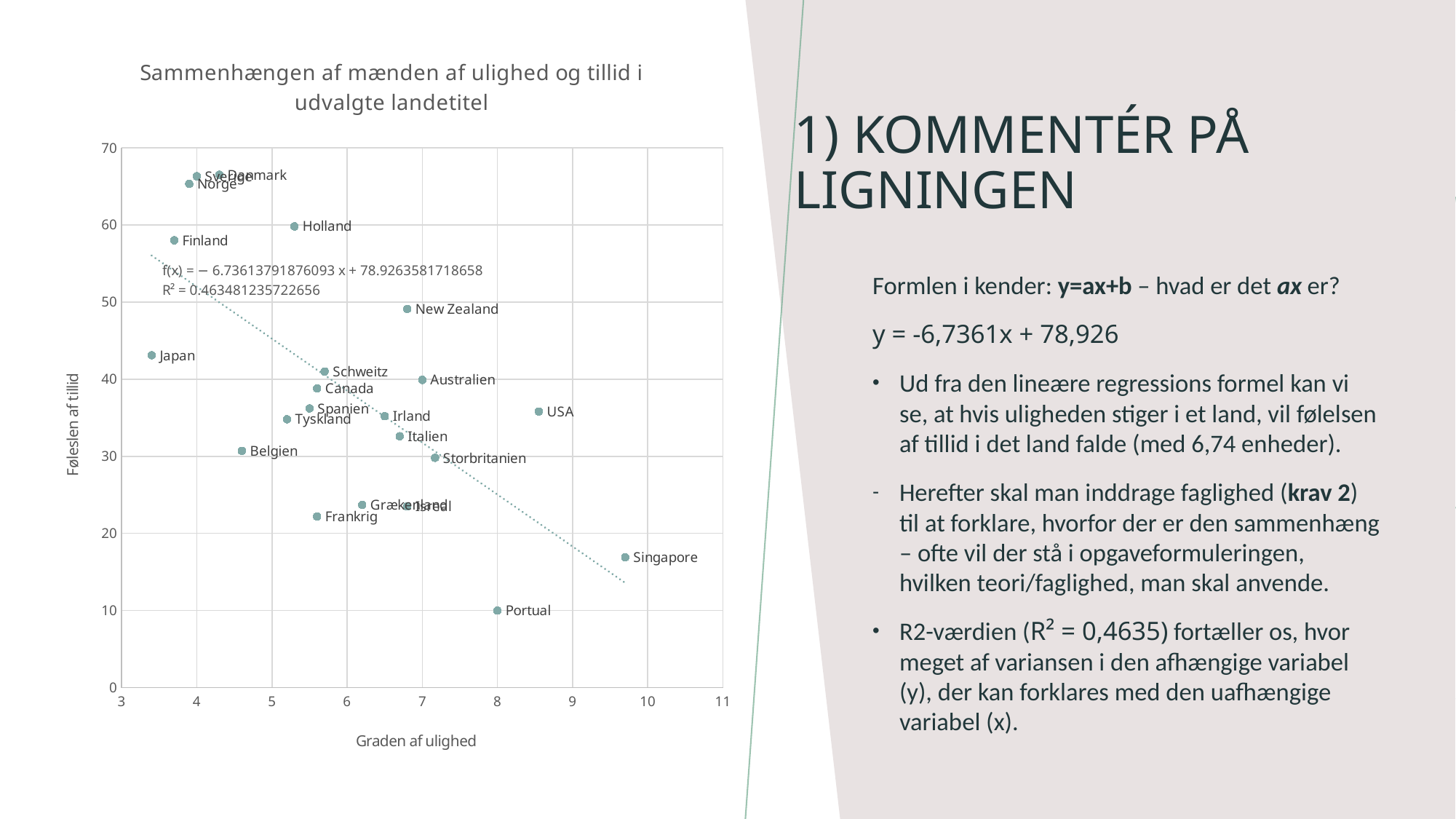
Which has the higher vertical-axis value, Portual or Singapore? Singapore What is the title of the chart? Sammenhængen af mænden af ulighed og tillid i udvalgte landetitel Does the trend line show trust rising or falling as inequality increases along the x axis? falling What R² value is printed on the chart? 0.463481235722656 Is the vertical-axis value for Singapore greater or less than 20? less Which country has the highest value on the horizontal axis (Graden af ulighed)? Singapore What kind of chart is shown on the slide? scatter chart Which country has the lowest value on the vertical axis (Føleslen af tillid)? Portual Which has the higher vertical-axis value, Japan or Belgien? Japan Is the vertical-axis value for Finland greater or less than 50? greater What is the label of the x axis of the chart? Graden af ulighed Is the vertical-axis value for Japan greater or less than 40? greater